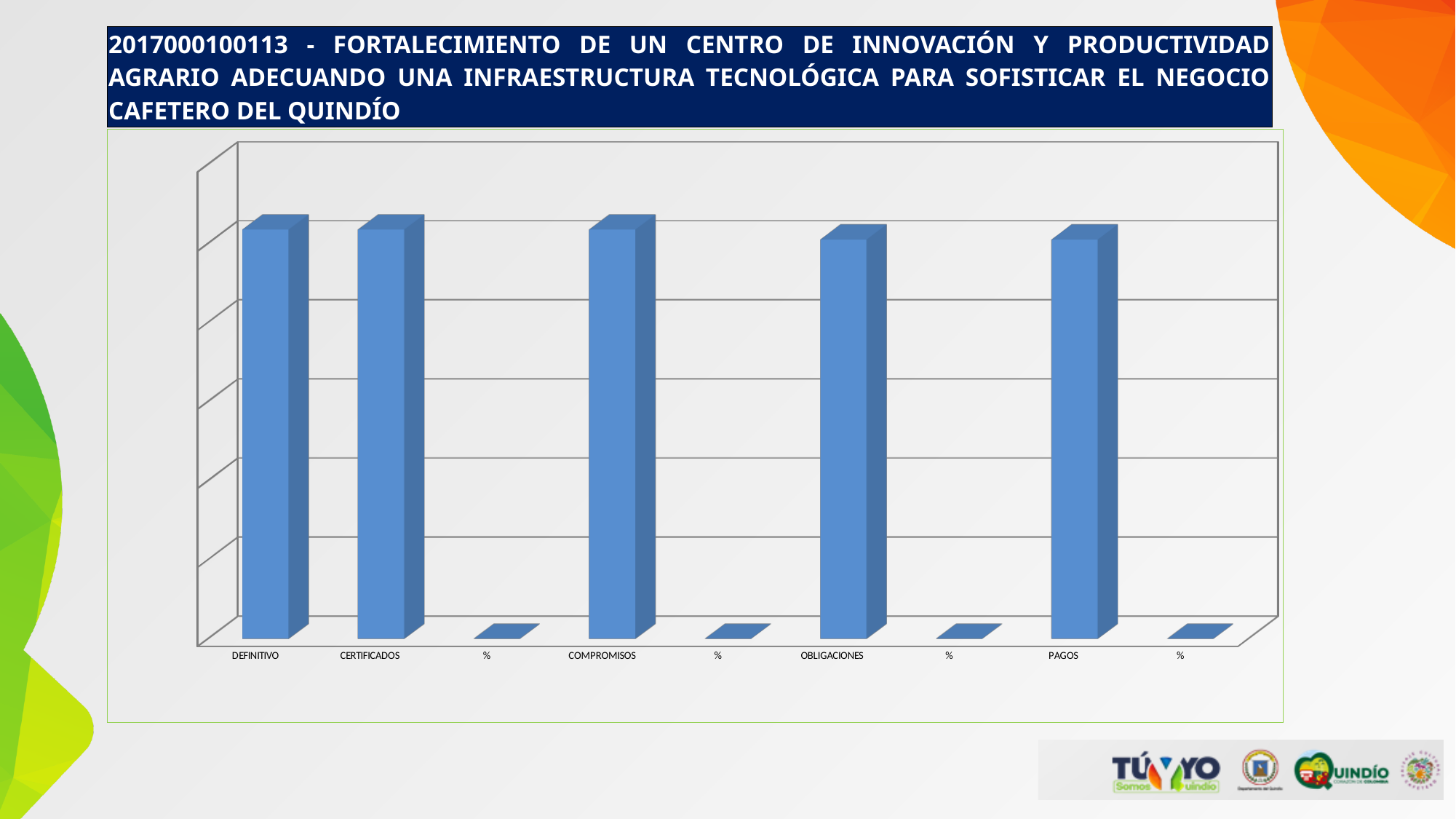
Which is larger, the value for COMPROMISOS or the value for the "%" category that follows it? COMPROMISOS Which is larger, the value for OBLIGACIONES or the value for the "%" category that follows it? OBLIGACIONES What is the label of the first category on the x axis? DEFINITIVO Which is larger, the value for PAGOS or the value for the last "%" category? PAGOS What colour are the bars in the chart? blue How many categories on the x axis are labelled "%"? 4 What kind of chart is shown on the slide? bar chart How many categories are shown along the x axis of the chart? 9